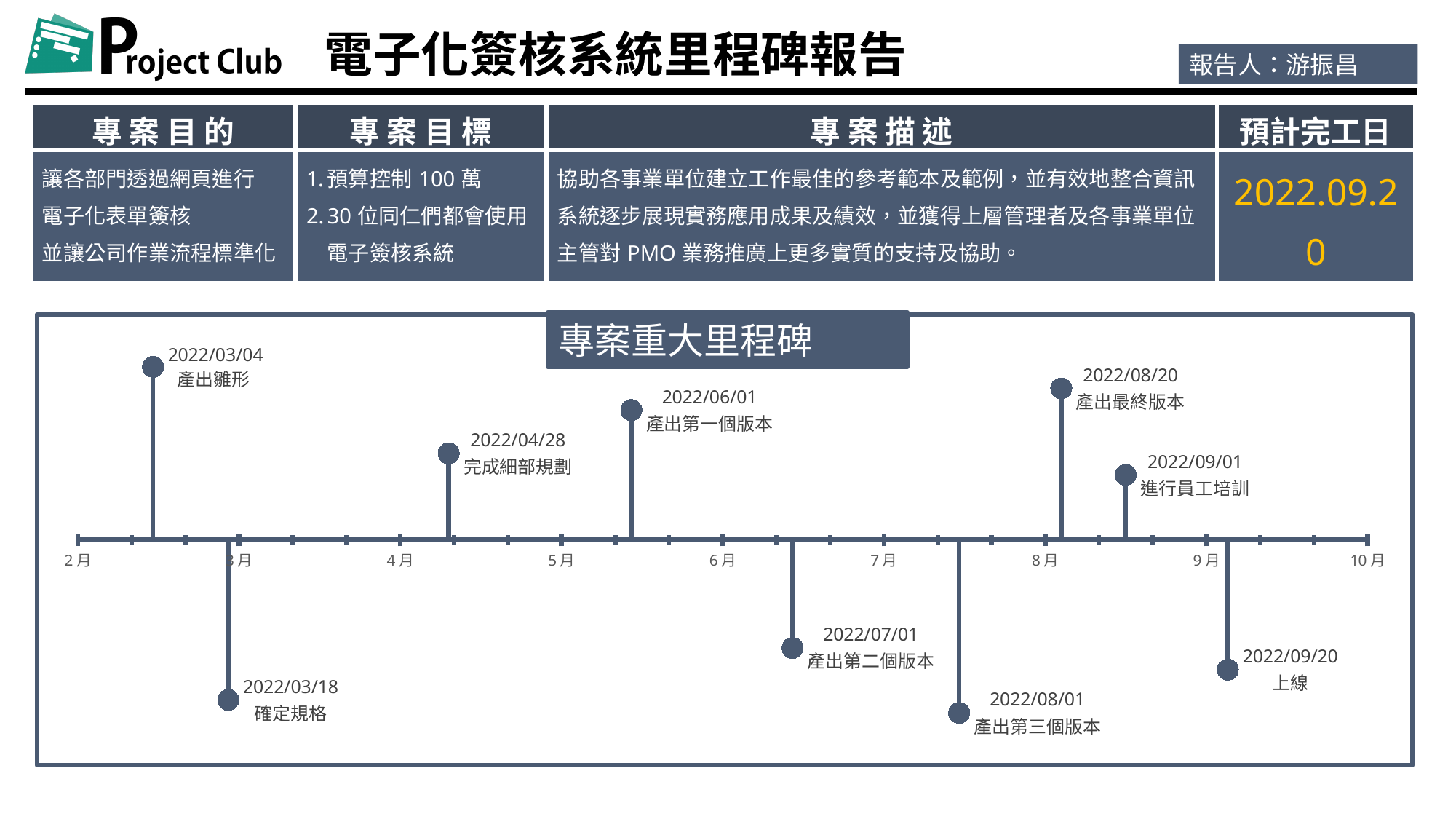
On what date is 完成細部規劃 scheduled? 2022/04/28 Which milestone is the earliest on the timeline? 產出雛形 (2022/03/04) How many milestones are plotted on the timeline? 9 On what date is the milestone 確定規格 scheduled? 2022/03/18 On what date is 進行員工培訓 scheduled? 2022/09/01 Which comes earlier on the timeline, 產出第二個版本 or 產出第三個版本? 產出第二個版本 Which milestone is scheduled for 2022/08/20? 產出最終版本 On what date is the milestone 產出雛形 scheduled? 2022/03/04 Which milestone is the latest on the timeline? 上線 (2022/09/20) What kind of chart is shown in the lower part of the slide? Timeline chart Which milestone is scheduled for 2022/06/01? 產出第一個版本 What is the title of the milestone chart? 專案重大里程碑